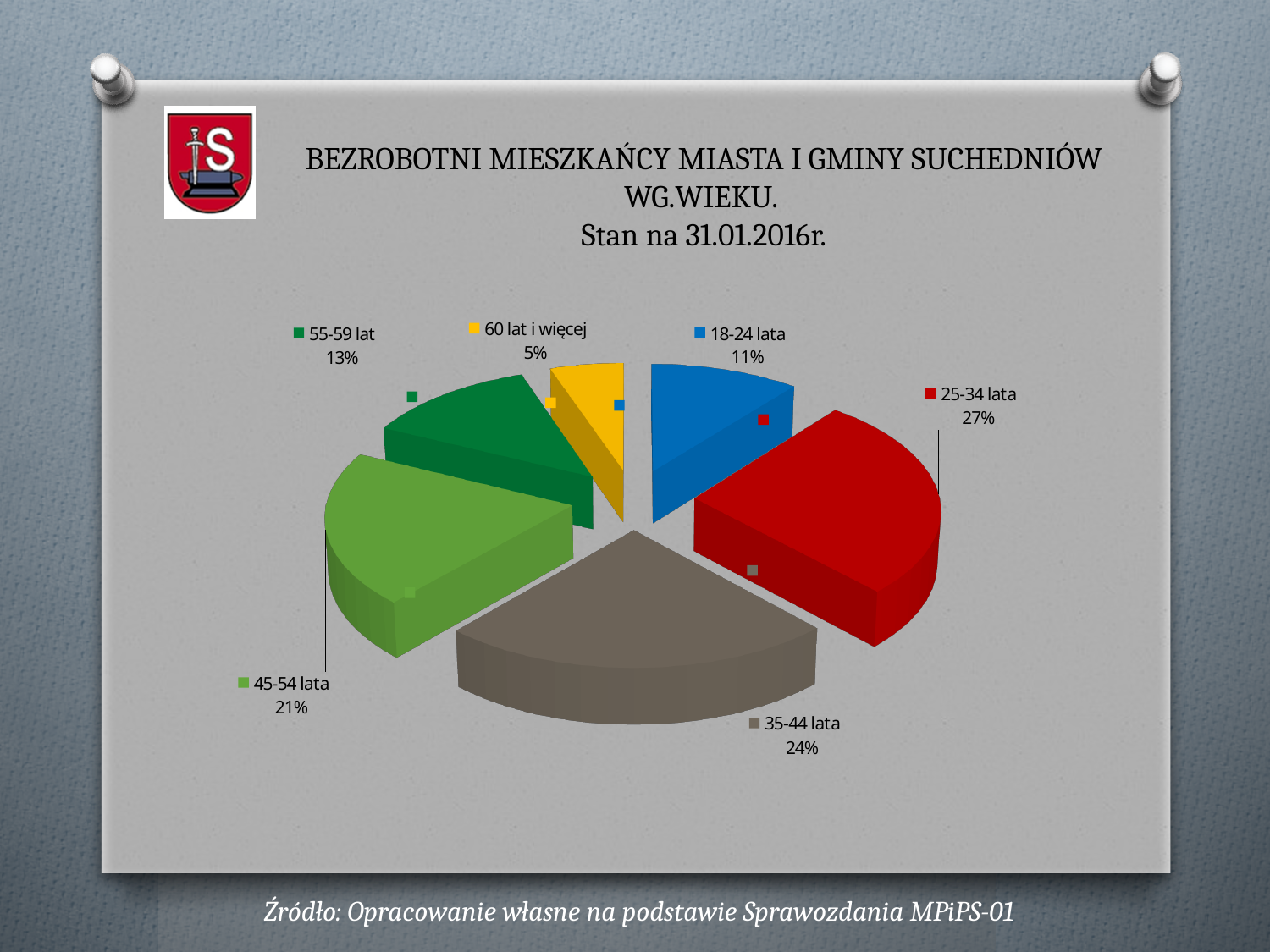
How many age categories are shown in the pie chart? 6 Which age group has the largest share of the pie? 25-34 lata What date is given in the chart title as the reference date? 31.01.2016r. Which is larger, the share for 18-24 lata or the share for 55-59 lat? 55-59 lat What share of the pie does the 25-34 lata slice represent? 27% What is the difference in percentage points between the 45-54 lata and 55-59 lat slices? 8 What kind of chart is shown on the slide? Pie chart What is the value shown for the 60 lat i więcej category? 5% What is the combined share of the 18-24 lata and 25-34 lata slices? 38% Which age group has the smallest share of the pie? 60 lat i więcej What is the value shown for the 35-44 lata category? 24% What colour is the 35-44 lata slice? Grey